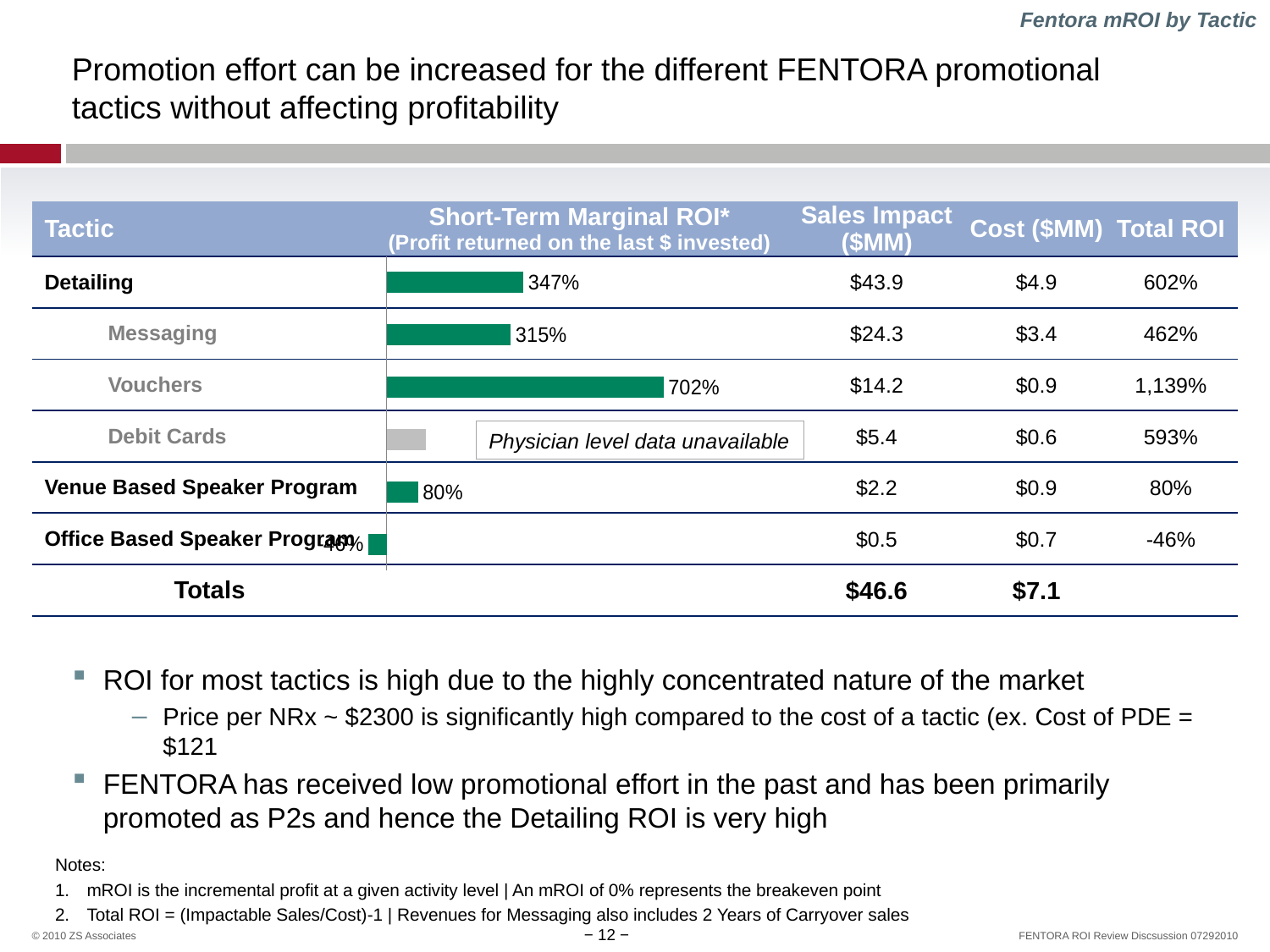
Which has a larger Short-Term Marginal ROI, Detailing or Messaging? Detailing What is the Short-Term Marginal ROI shown for Detailing? 347% What is the Short-Term Marginal ROI shown for Messaging? 315% What is the difference between the Short-Term Marginal ROI for Vouchers and for Detailing? 355% Which tactic has the highest Short-Term Marginal ROI bar? Vouchers What is the difference between the Short-Term Marginal ROI for Detailing and for Messaging? 32% Which tactic has the lowest Short-Term Marginal ROI bar? Office Based Speaker Program What is the Short-Term Marginal ROI shown for the Venue Based Speaker Program? 80% What does the chart say in place of a Short-Term Marginal ROI value for Debit Cards? Physician level data unavailable Which has a larger Short-Term Marginal ROI, Messaging or the Venue Based Speaker Program? Messaging What kind of chart is used to show the Short-Term Marginal ROI values? Bar chart What is the Short-Term Marginal ROI shown for Vouchers? 702%